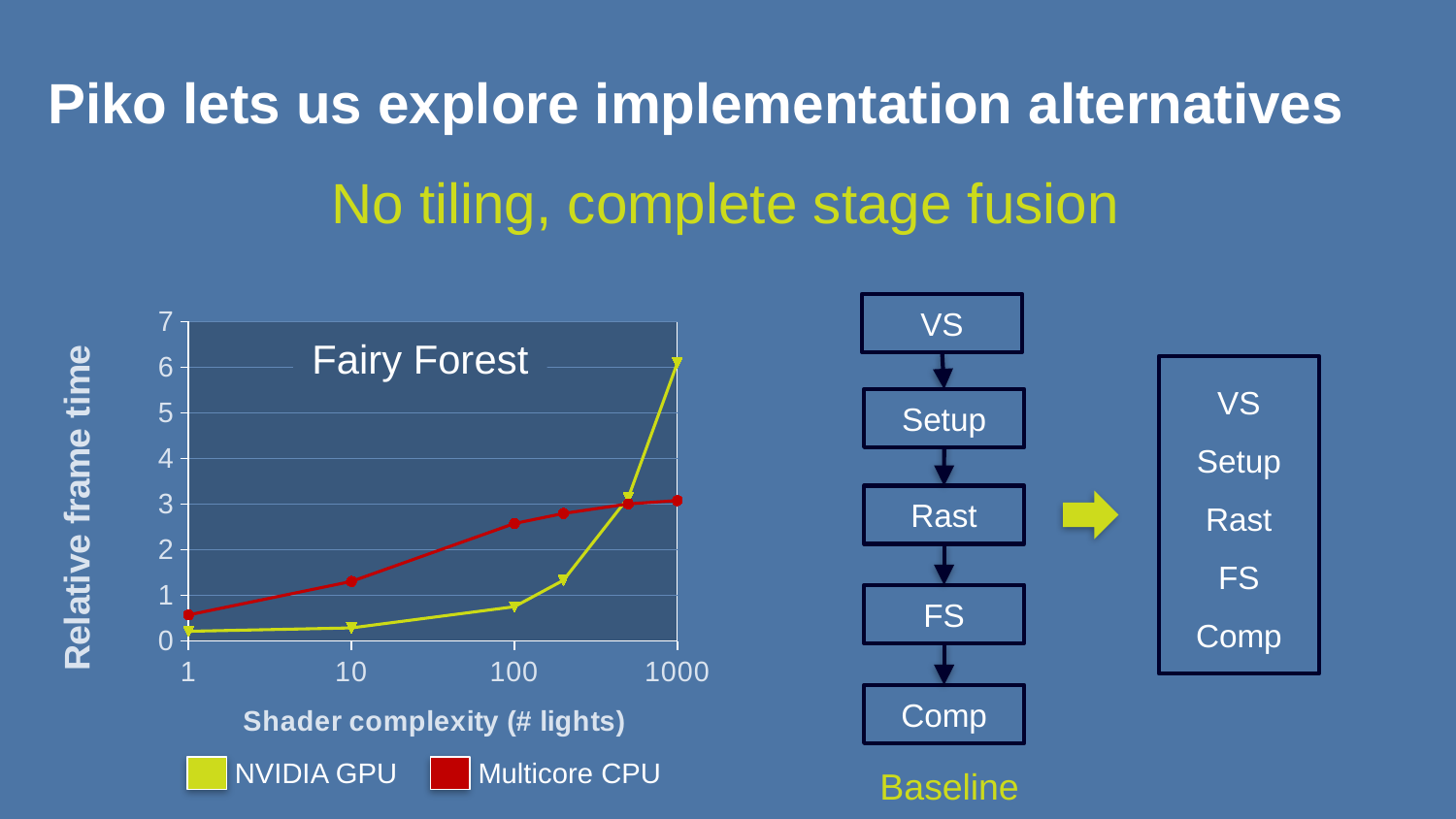
Is the NVIDIA GPU value at 10 lights greater or less than 1? less Does the NVIDIA GPU relative frame time rise or fall as shader complexity increases? rise At 1000 lights, which series has the higher relative frame time, NVIDIA GPU or Multicore CPU? NVIDIA GPU Is the NVIDIA GPU value at 1000 lights greater or less than 5? greater At 100 lights, which series has the higher relative frame time, NVIDIA GPU or Multicore CPU? Multicore CPU What kind of chart is shown on the slide? line chart Is the Multicore CPU value at 10 lights greater or less than 1? greater Which series reaches the highest relative frame time anywhere on the chart? NVIDIA GPU How many series does the chart's legend list? 2 What are the two series named in the chart's legend? NVIDIA GPU and Multicore CPU What is the title shown inside the chart's plot area? Fairy Forest